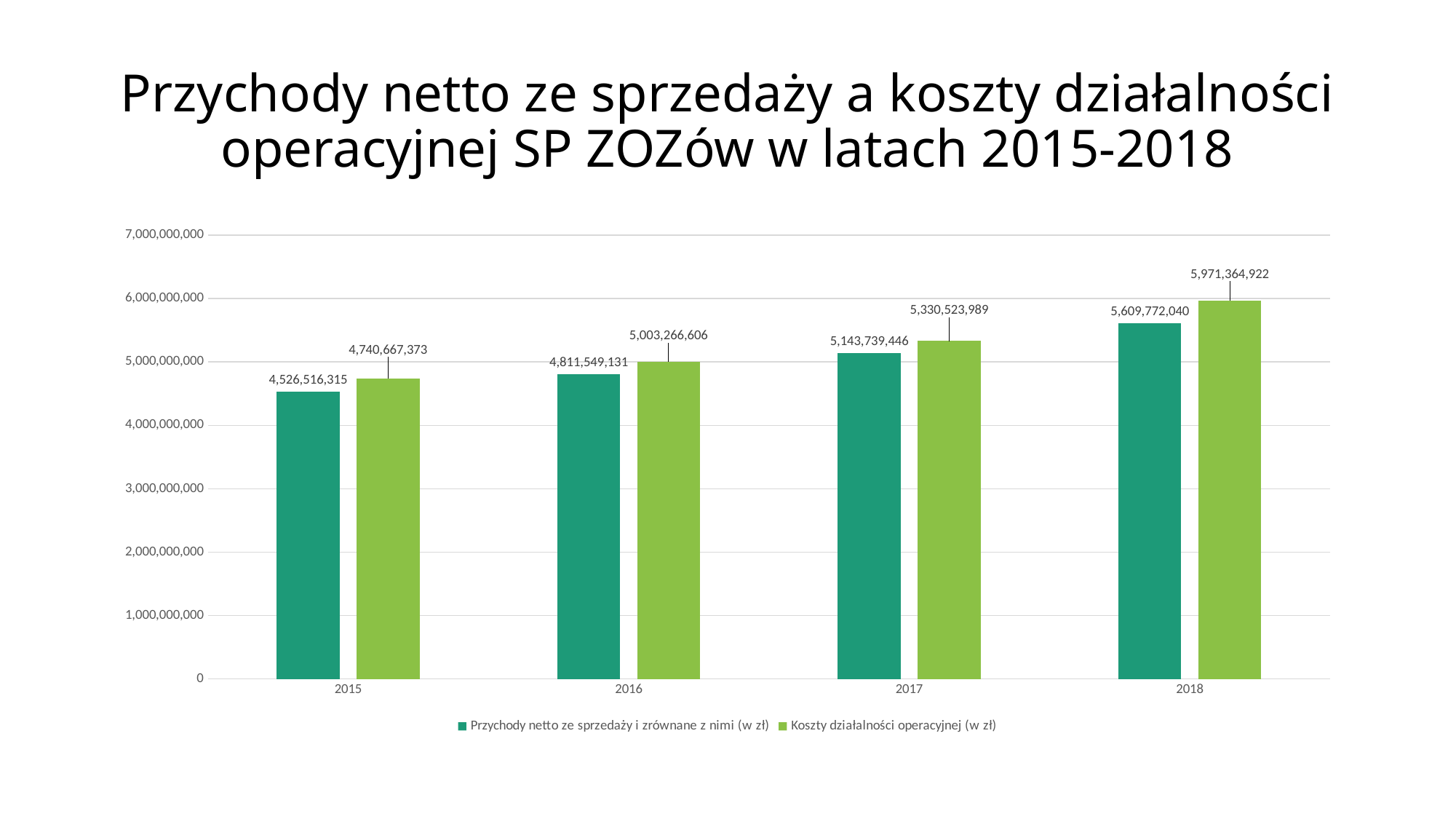
What is the value of Koszty działalności operacyjnej (w zł) for 2018? 5,971,364,922 In which year is Koszty działalności operacyjnej (w zł) lowest? 2015 What is the difference between Koszty działalności operacyjnej and Przychody netto ze sprzedaży in 2018? 361,592,882 In 2016, which is larger: Przychody netto ze sprzedaży or Koszty działalności operacyjnej? Koszty działalności operacyjnej By how much did Przychody netto ze sprzedaży i zrównane z nimi increase from 2015 to 2018? 1,083,255,725 How many series does the legend list? 2 How many years are shown on the x axis? 4 Is the value of Koszty działalności operacyjnej for 2016 greater or less than 5,000,000,000? greater What is the value of Koszty działalności operacyjnej (w zł) for 2017? 5,330,523,989 Do the values of Koszty działalności operacyjnej rise or fall from 2015 to 2018? rise What is the value of Przychody netto ze sprzedaży i zrównane z nimi (w zł) for 2015? 4,526,516,315 In which year is Przychody netto ze sprzedaży i zrównane z nimi (w zł) highest? 2018